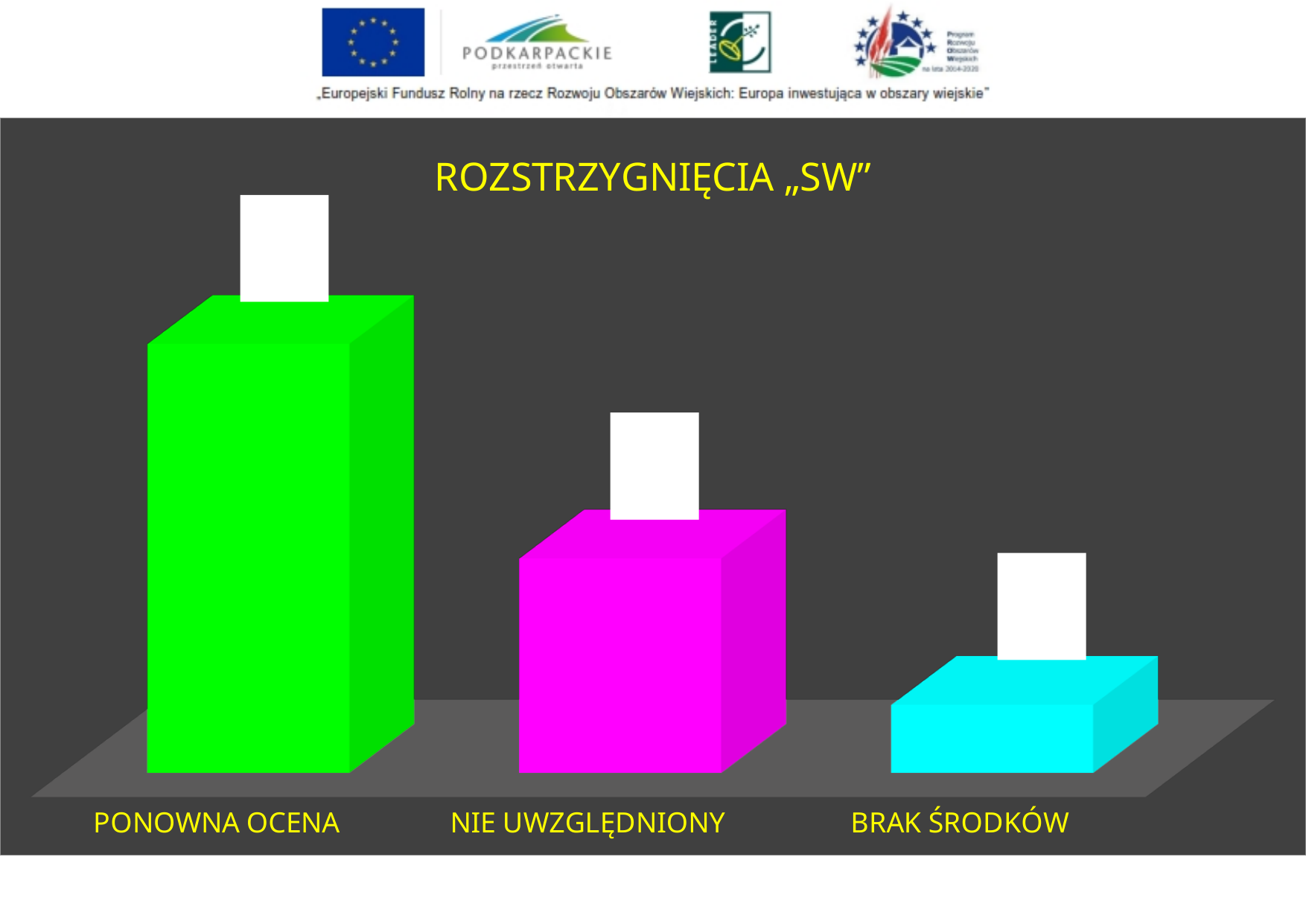
Which is larger, the bar for NIE UWZGLĘDNIONY or the bar for BRAK ŚRODKÓW? NIE UWZGLĘDNIONY Which category has the highest bar? PONOWNA OCENA What kind of chart is shown on the slide? bar chart Which is larger, the bar for PONOWNA OCENA or the bar for NIE UWZGLĘDNIONY? PONOWNA OCENA Do the bar heights rise or fall from left to right across the chart? fall What colour is the bar for BRAK ŚRODKÓW? cyan What is the title of the chart? ROZSTRZYGNIĘCIA „SW” Which category has the lowest bar? BRAK ŚRODKÓW How many categories are plotted in the chart? 3